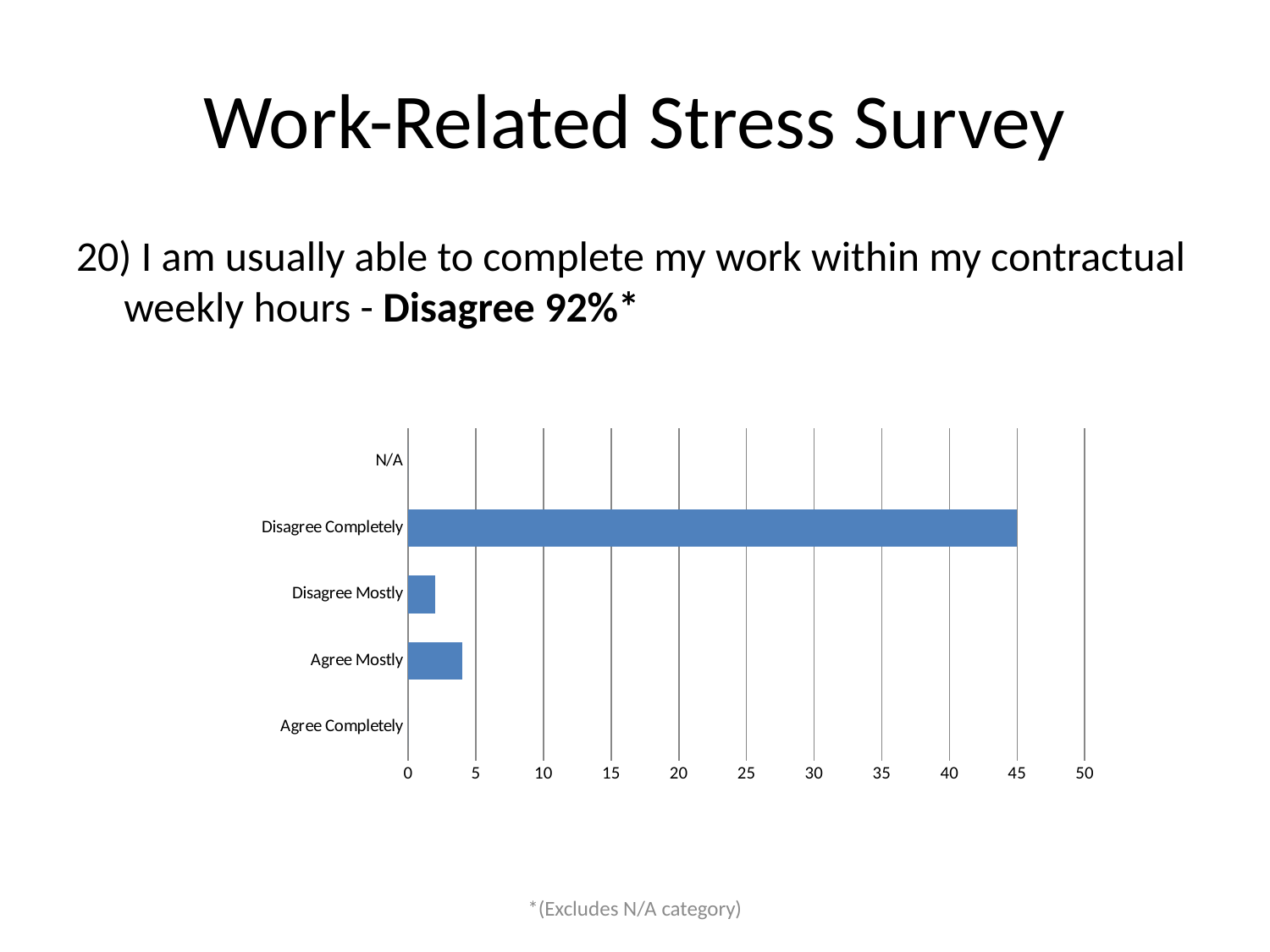
Which is larger, the value for Disagree Completely or the value for Agree Mostly? Disagree Completely Which category has the highest value in the chart? Disagree Completely Is the value for Disagree Mostly greater or less than 5? less What type of chart is shown on the slide? bar chart How many categories are shown on the chart? 5 Is the value for Disagree Completely greater or less than 40? greater Is the value for Agree Mostly greater or less than 5? less What is the title of the slide containing the chart? Work-Related Stress Survey What is the value for Disagree Completely? 45 What is the highest value shown on the horizontal axis of the chart? 50 Which is larger, the value for Agree Mostly or the value for Disagree Mostly? Agree Mostly